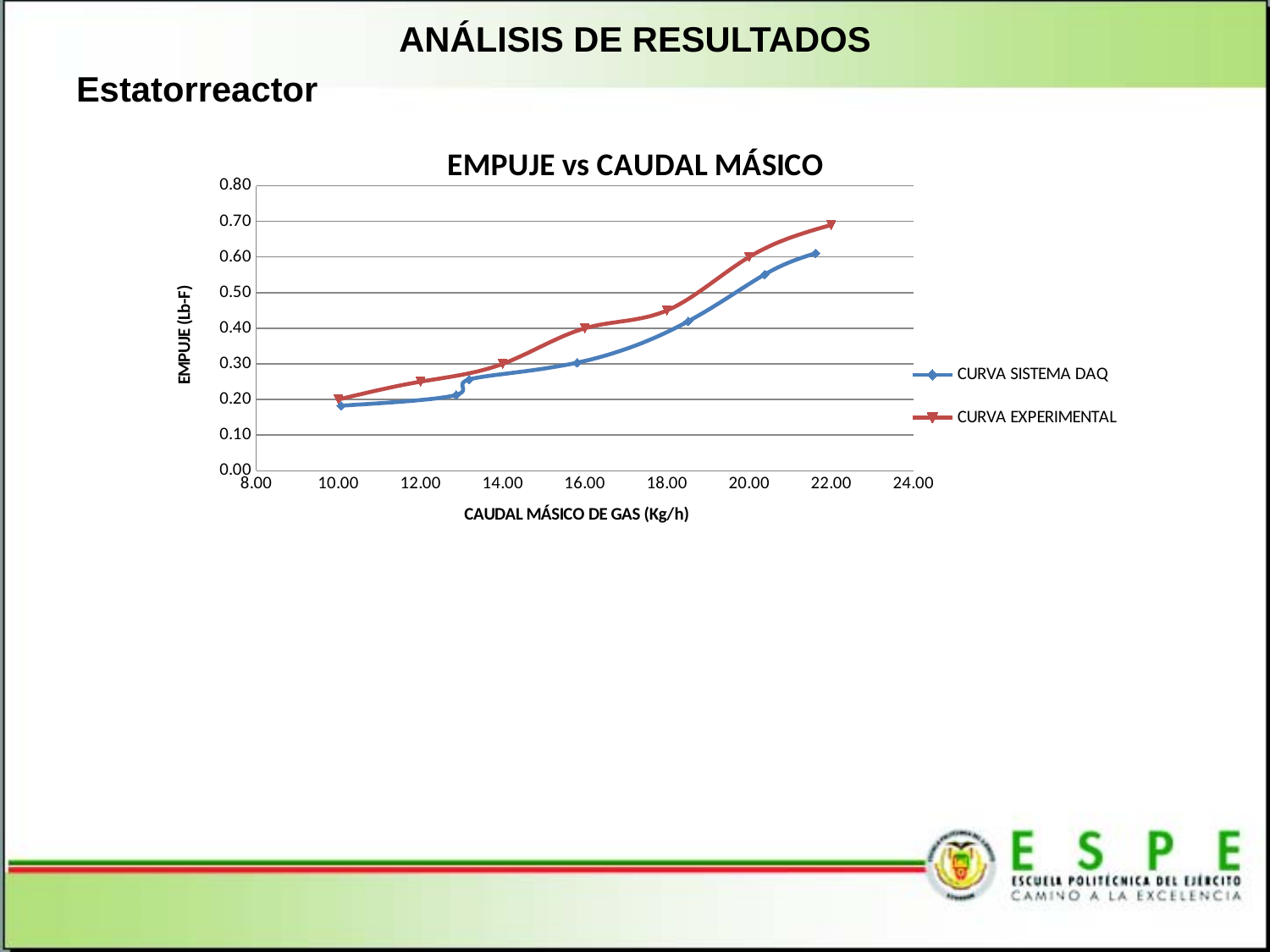
How many data points are plotted for the CURVA EXPERIMENTAL series? 7 Is the value of CURVA EXPERIMENTAL at 22.00 Kg/h greater or less than 0.60? greater At a caudal másico of 16.00 Kg/h, which series has the higher empuje, CURVA SISTEMA DAQ or CURVA EXPERIMENTAL? CURVA EXPERIMENTAL What is the title of the chart? EMPUJE vs CAUDAL MÁSICO Does the CURVA EXPERIMENTAL series rise or fall as the caudal másico increases along the x axis? rise How many series does the legend list? 2 Is the value of CURVA EXPERIMENTAL at 16.00 Kg/h greater or less than 0.50? less Is the value of CURVA SISTEMA DAQ at 10.00 Kg/h greater or less than 0.30? less Which series reaches the highest empuje value on the chart? CURVA EXPERIMENTAL What kind of chart is shown on the slide? line chart Does the CURVA SISTEMA DAQ series rise or fall as the caudal másico increases along the x axis? rise What is the label of the vertical axis? EMPUJE (Lb-F)